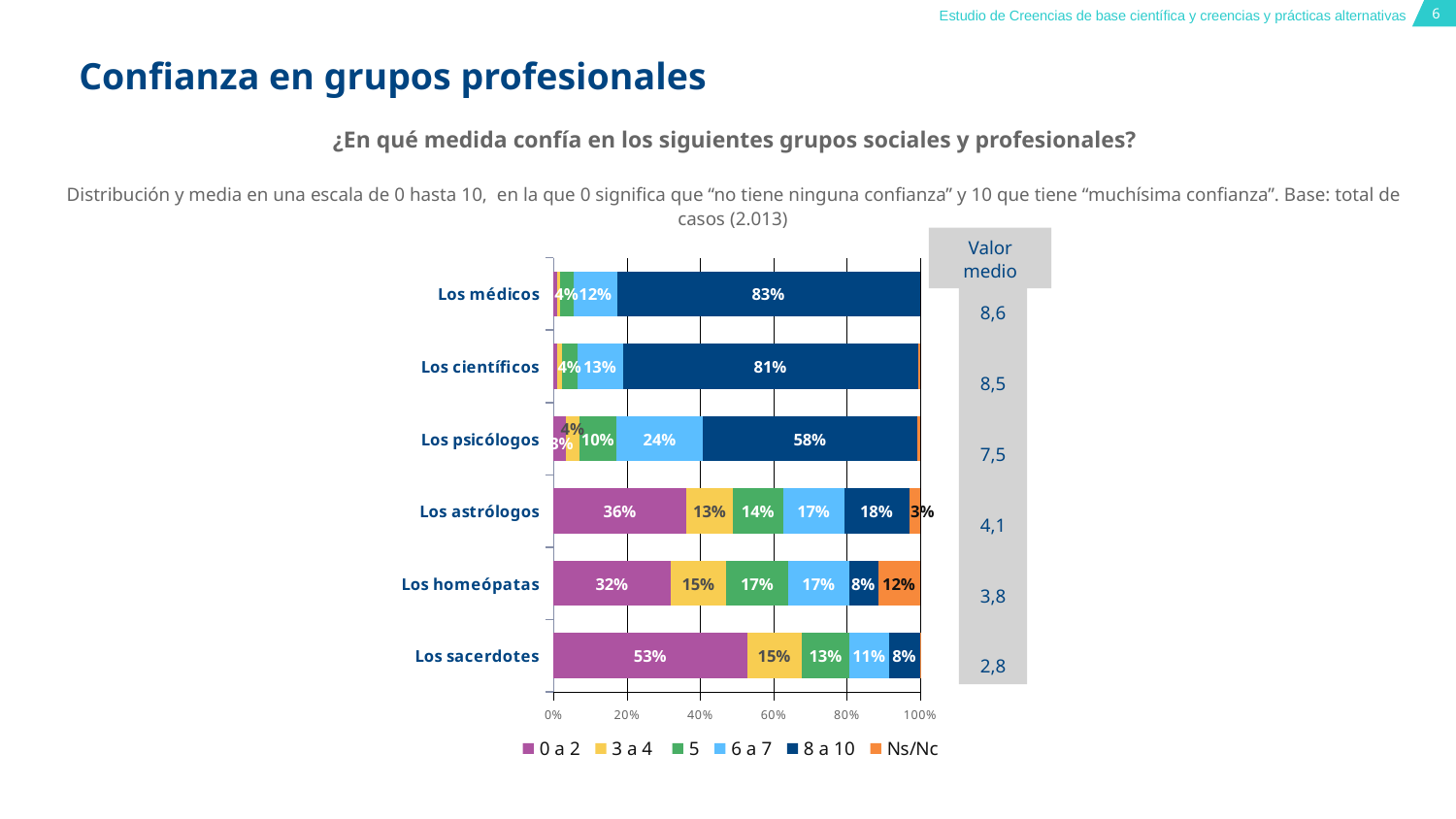
What percentage of respondents rated Los sacerdotes 0 a 2? 53% How many professional groups are shown in the chart? 6 What is the Ns/Nc share for Los homeópatas? 12% What percentage of respondents rated Los médicos 8 a 10? 83% What is the 6 a 7 share for Los psicólogos? 24% How many series does the legend list? 6 Which professional group has the highest 8 a 10 share? Los médicos What is the difference between the 0 a 2 share for Los sacerdotes and for Los astrólogos? 17% Which is larger: the 8 a 10 share for Los astrólogos or for Los homeópatas? Los astrólogos Which professional group has the lowest 8 a 10 share? Los sacerdotes and Los homeópatas (both 8%) What kind of chart is shown on the slide? Stacked bar chart What is the 'Valor medio' shown for Los científicos? 8,5